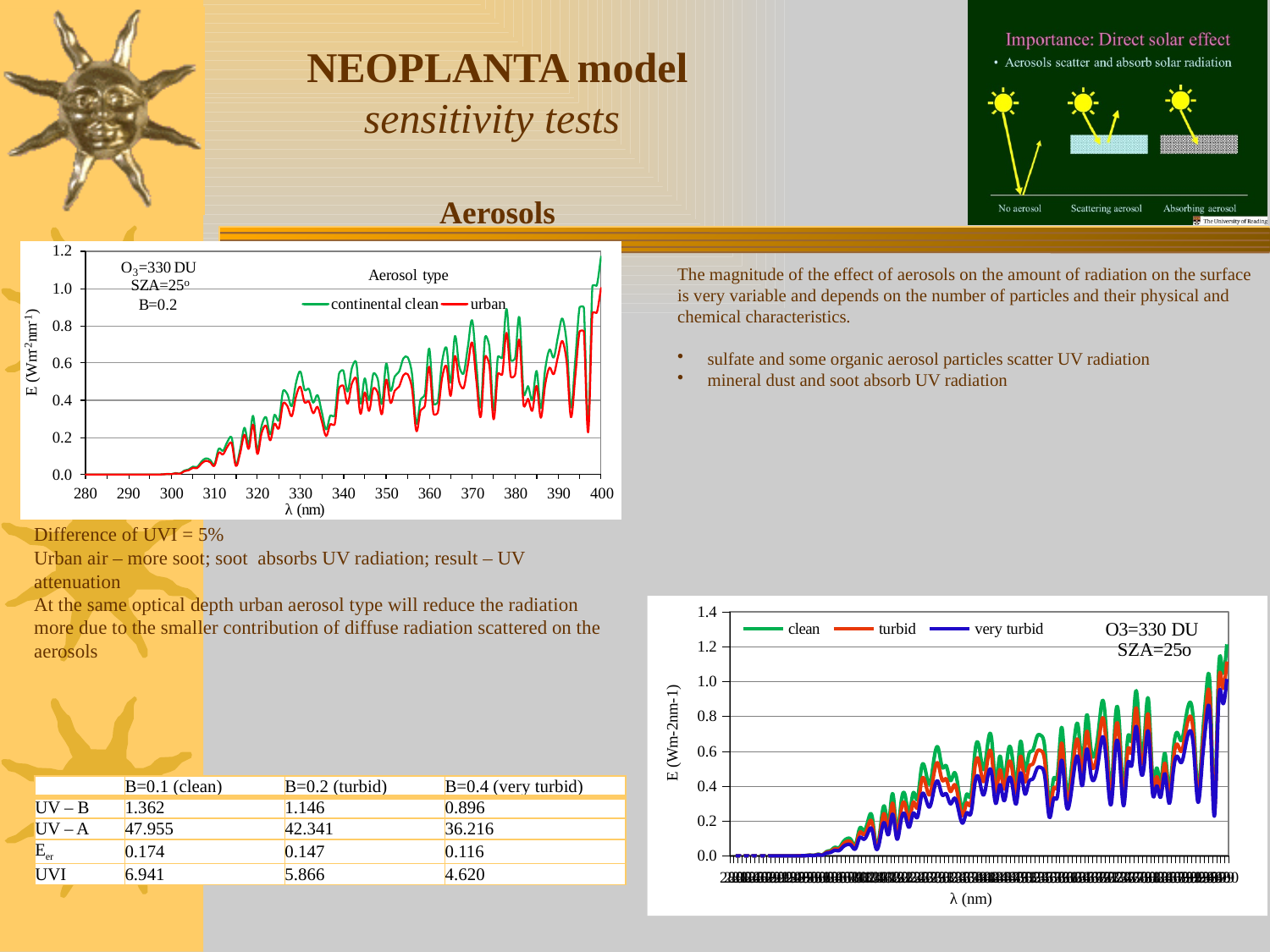
In the bottom-right chart, which series generally has the highest values? clean In the top-left chart, is the value for continental clean at 400 nm greater or less than 1.0? greater In the top-left chart, is the value for urban at 290 nm greater or less than 0.2? less How many series does the legend of the top-left chart (continental clean / urban) list? 2 What kind of chart is the top-left chart titled 'Aerosol type'? line chart In the top-left chart, which series generally has higher values, continental clean or urban? continental clean In the bottom-right chart, what colour is the line for the very turbid series? blue How many series does the legend of the bottom-right chart (clean / turbid / very turbid) list? 3 What is the x-axis label of the top-left chart? λ (nm) In the top-left chart, do the values overall rise or fall as wavelength increases from 280 to 400 nm? rise In the bottom-right chart, is the peak value of the clean series at the right end of the x axis greater or less than 1.0? greater In the bottom-right chart, which series generally has the lowest values? very turbid